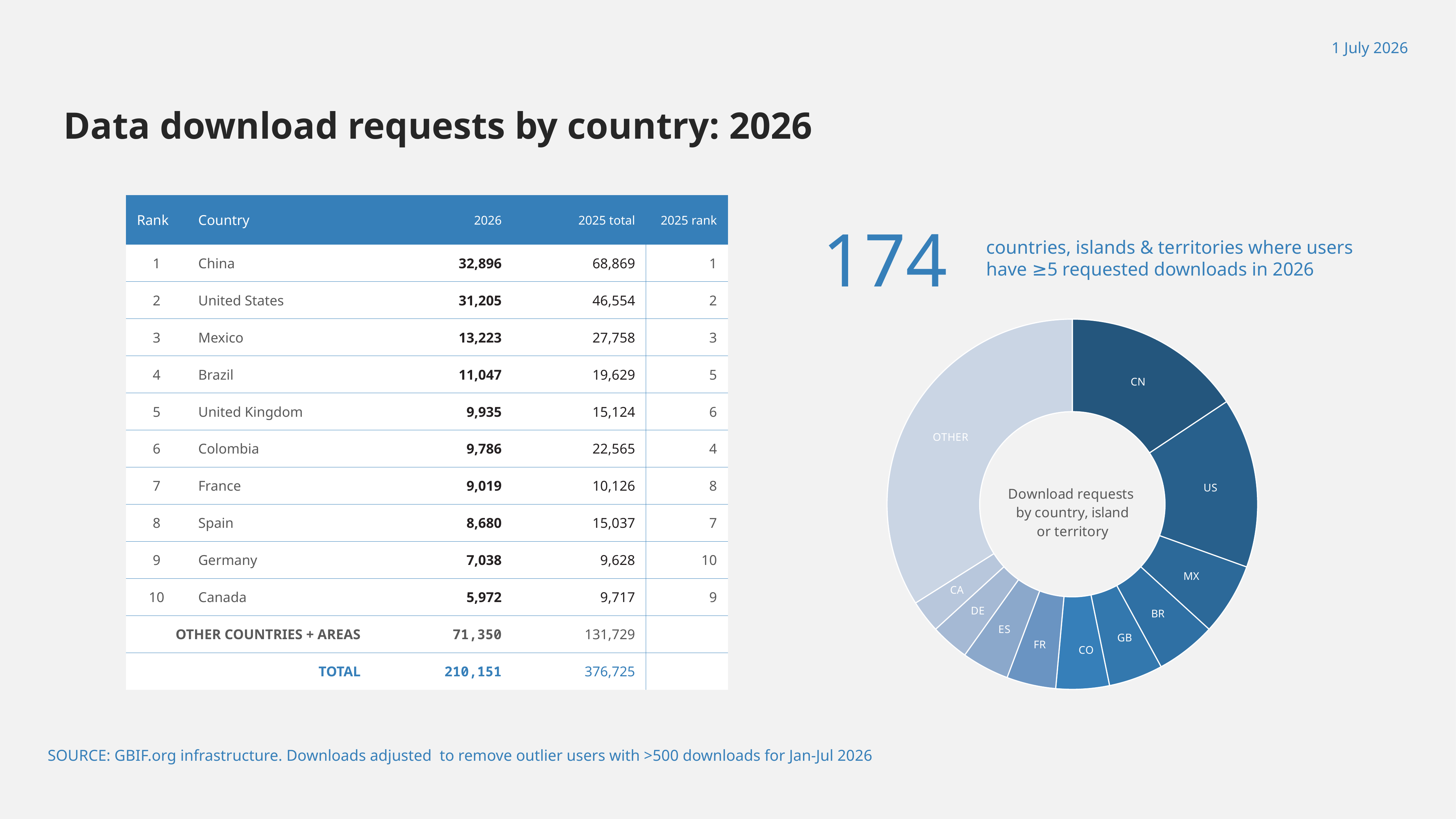
According to the slide, how many download requests did China (CN) have in 2026? 32,896 Which slice of the donut chart is the largest? OTHER What text is written in the centre of the donut chart? Download requests by country, island or territory According to the slide, how many download requests did Canada (CA) have in 2026? 5,972 Which individual country slice in the donut chart is the largest? CN How many slices does the donut chart have? 11 What kind of chart is shown on the right of the slide? donut (pie) chart What is the difference between the 2026 download requests for China and the United States? 1,691 What is the total number of download requests in 2026 shown on the slide? 210,151 How many countries, islands & territories had users with ≥5 requested downloads in 2026? 174 Which slice of the donut chart is the smallest? CA Which slice is larger in the donut chart, MX or BR? MX